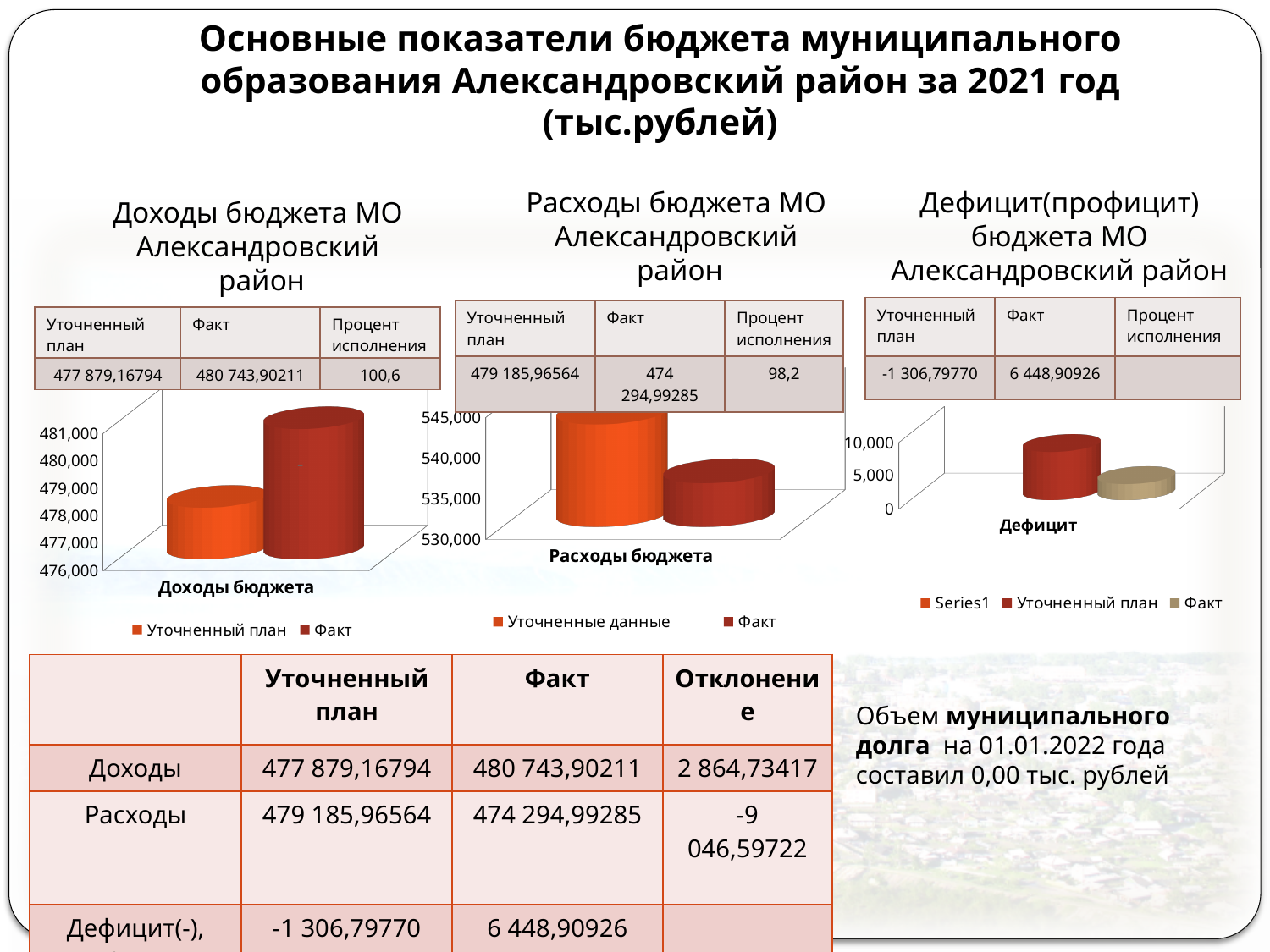
For the 'Доходы бюджета МО Александровский район' chart, what is the difference between Факт and Уточненный план as shown in the bottom table (Отклонение)? 2 864,73417 In the 'Доходы бюджета МО Александровский район' chart, is the value for Уточненный план greater or less than 479,000? less In the 'Доходы бюджета МО Александровский район' chart, which series has the taller bar, Уточненный план or Факт? Факт In the 'Расходы бюджета МО Александровский район' chart, which series has the taller bar, Уточненные данные or Факт? Уточненные данные In the 'Дефицит(профицит) бюджета МО Александровский район' chart, how many series does the legend list? 3 In the 'Доходы бюджета МО Александровский район' chart, what is the Факт value shown in the table above the chart? 480 743,90211 In the 'Расходы бюджета МО Александровский район' chart, what is the category label on the x axis? Расходы бюджета In the 'Расходы бюджета МО Александровский район' chart, how many series does the legend list? 2 In the 'Дефицит(профицит) бюджета МО Александровский район' chart, which bar is taller, Уточненный план or Факт? Уточненный план What kind of chart is the 'Доходы бюджета МО Александровский район' chart? bar chart In the 'Доходы бюджета МО Александровский район' chart, how many series does the legend list? 2 In the 'Доходы бюджета МО Александровский район' chart, what is the Уточненный план value shown in the table above the chart? 477 879,16794